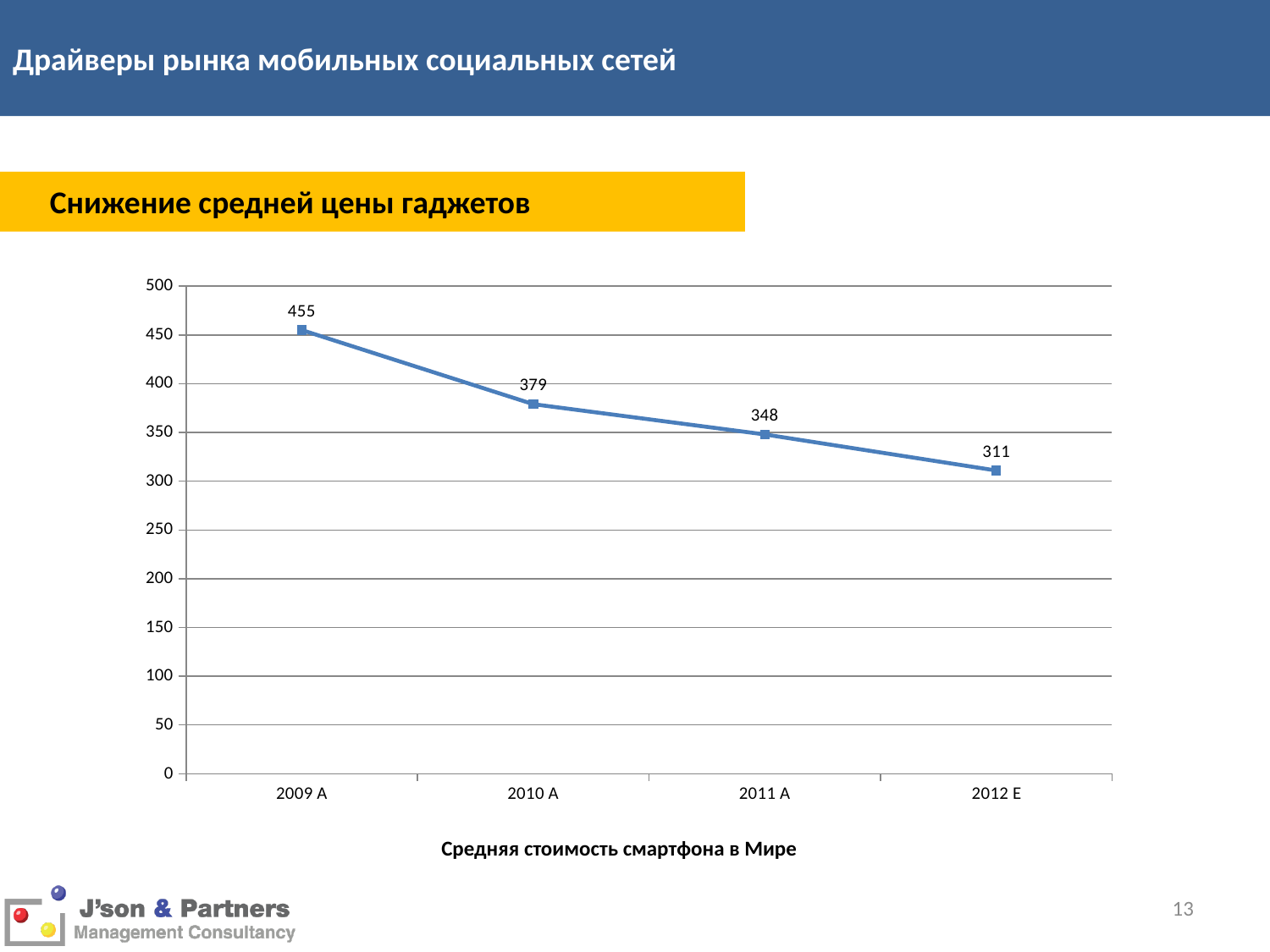
What kind of chart is shown on the slide? Line chart What is the difference between the values for 2010 A and 2011 A? 31 Which year has the lowest value? 2012 E Which year has the highest value? 2009 A What is the value for 2009 A? 455 What is the value for 2012 E? 311 Do the values rise or fall from 2009 A to 2012 E? Fall What is the difference between the values for 2009 A and 2012 E? 144 Which is larger, the value for 2010 A or the value for 2011 A? 2010 A How many data points are plotted on the chart? 4 What is the value for 2010 A? 379 What is the value for 2011 A? 348